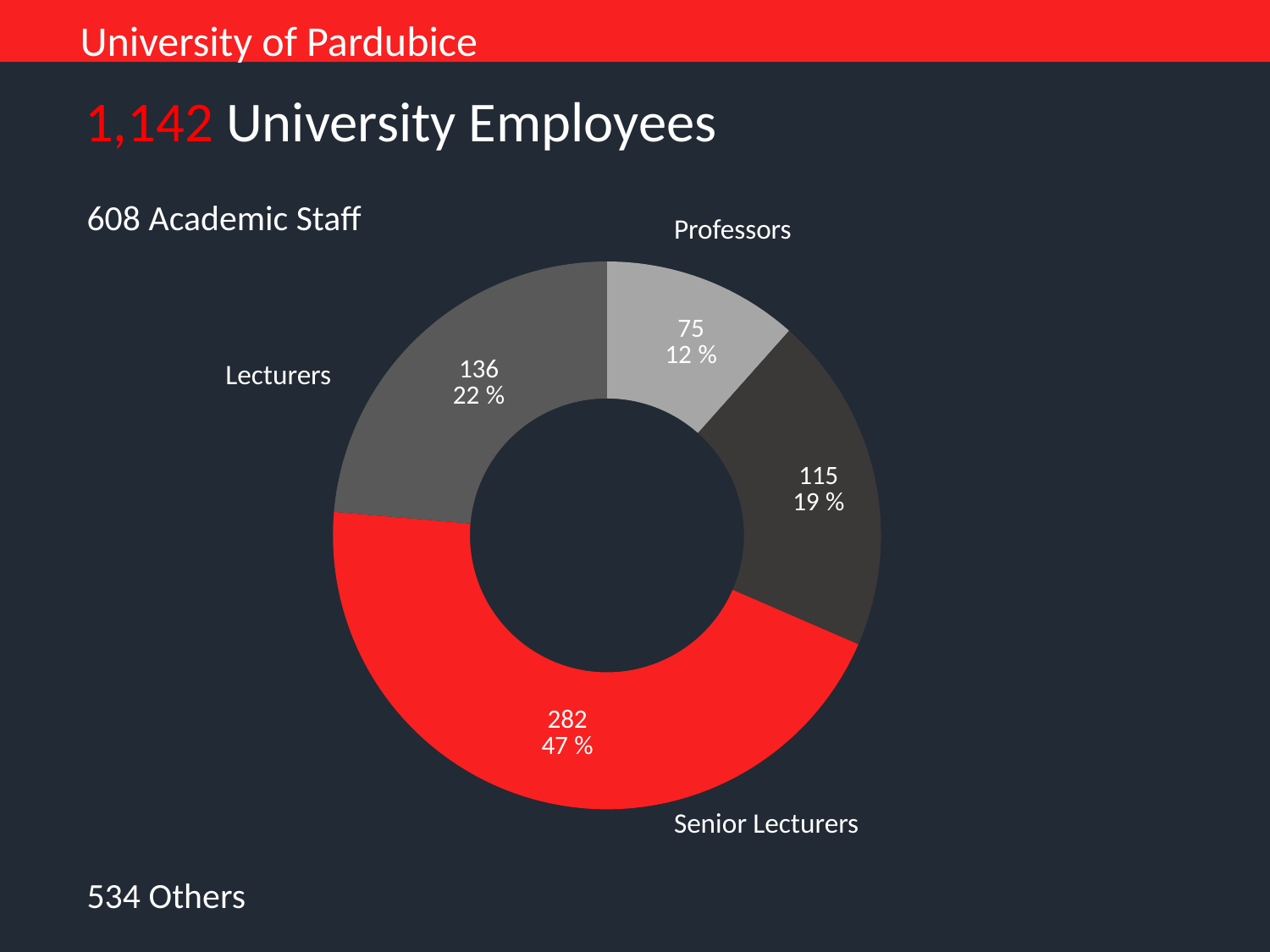
What is the value shown for Professors? 75 What is the value shown for Senior Lecturers? 282 Which is larger, the value for Lecturers or the value for Professors? Lecturers What is the value shown for Lecturers? 136 What percentage share is shown for Senior Lecturers? 47 % What colour is the Senior Lecturers slice? Red How many slices does the doughnut chart have? 4 Which category has the largest slice? Senior Lecturers What is the difference between the values for Senior Lecturers and Lecturers? 146 What kind of chart is shown on the slide? Doughnut chart What percentage share is shown for Professors? 12 % Which labelled category has the smallest slice? Professors